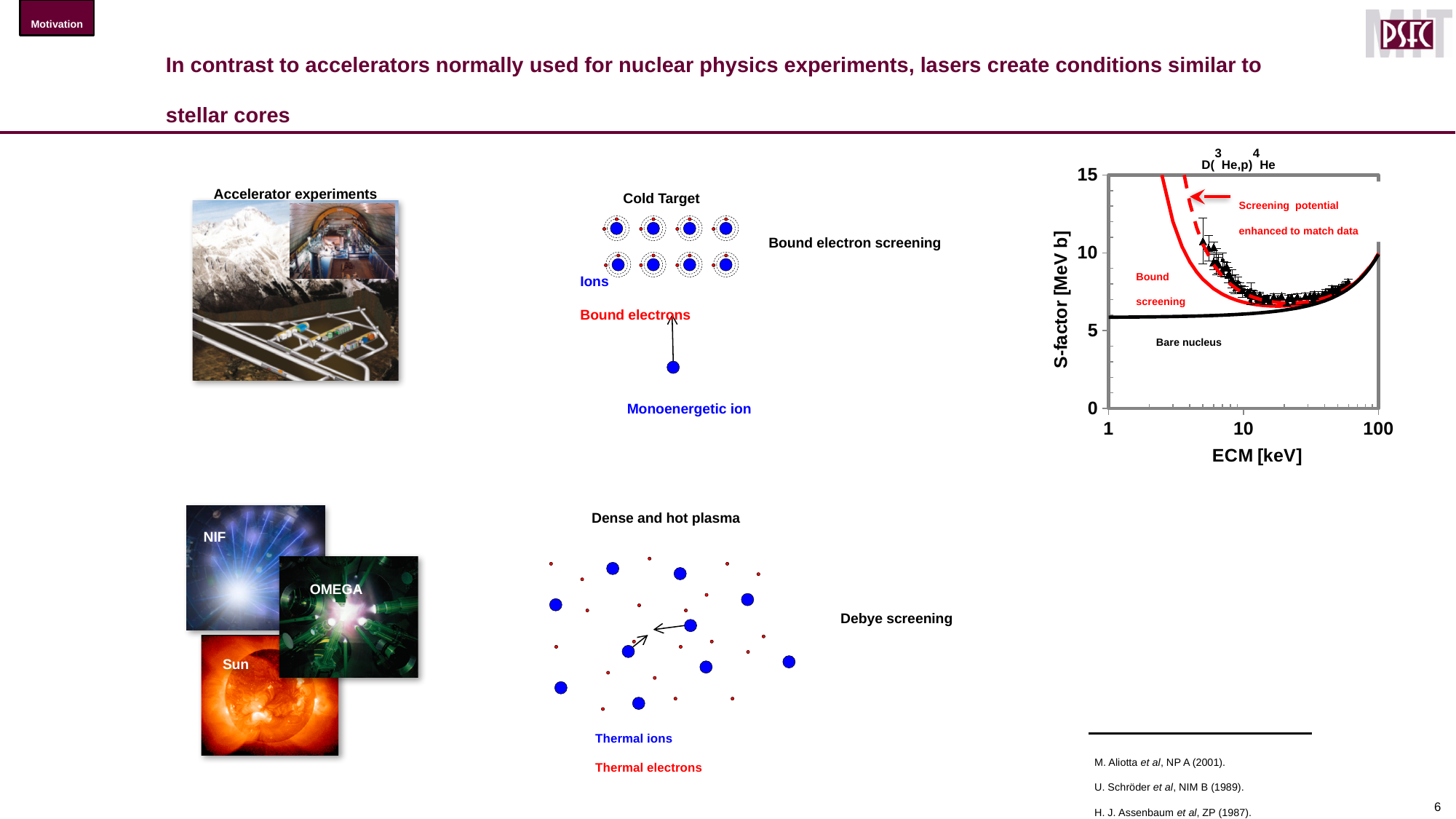
How many labelled curves are drawn on the S-factor chart? 3 On the S-factor chart, does the Bound screening curve rise or fall as ECM increases from 3 keV to 10 keV? fall On the S-factor chart, is the Bare nucleus curve at ECM = 100 keV greater or less than 5 MeV b? greater On the S-factor chart, which curve is drawn as a dashed line? Screening potential enhanced to match data On the S-factor chart, at ECM = 5 keV, which curve is higher: Bound screening or Bare nucleus? Bound screening What is the label of the y axis of the S-factor chart? S-factor [MeV b] What is the highest tick value shown on the y axis of the S-factor chart? 15 On the S-factor chart, is the Bare nucleus curve at ECM = 10 keV greater or less than 10 MeV b? less What kind of chart is shown on the right of the slide? line chart On the S-factor chart, is the Bare nucleus curve at ECM = 1 keV greater or less than 5 MeV b? greater On the S-factor chart, does the Bare nucleus curve rise or fall as ECM increases from 1 to 100 keV? rise